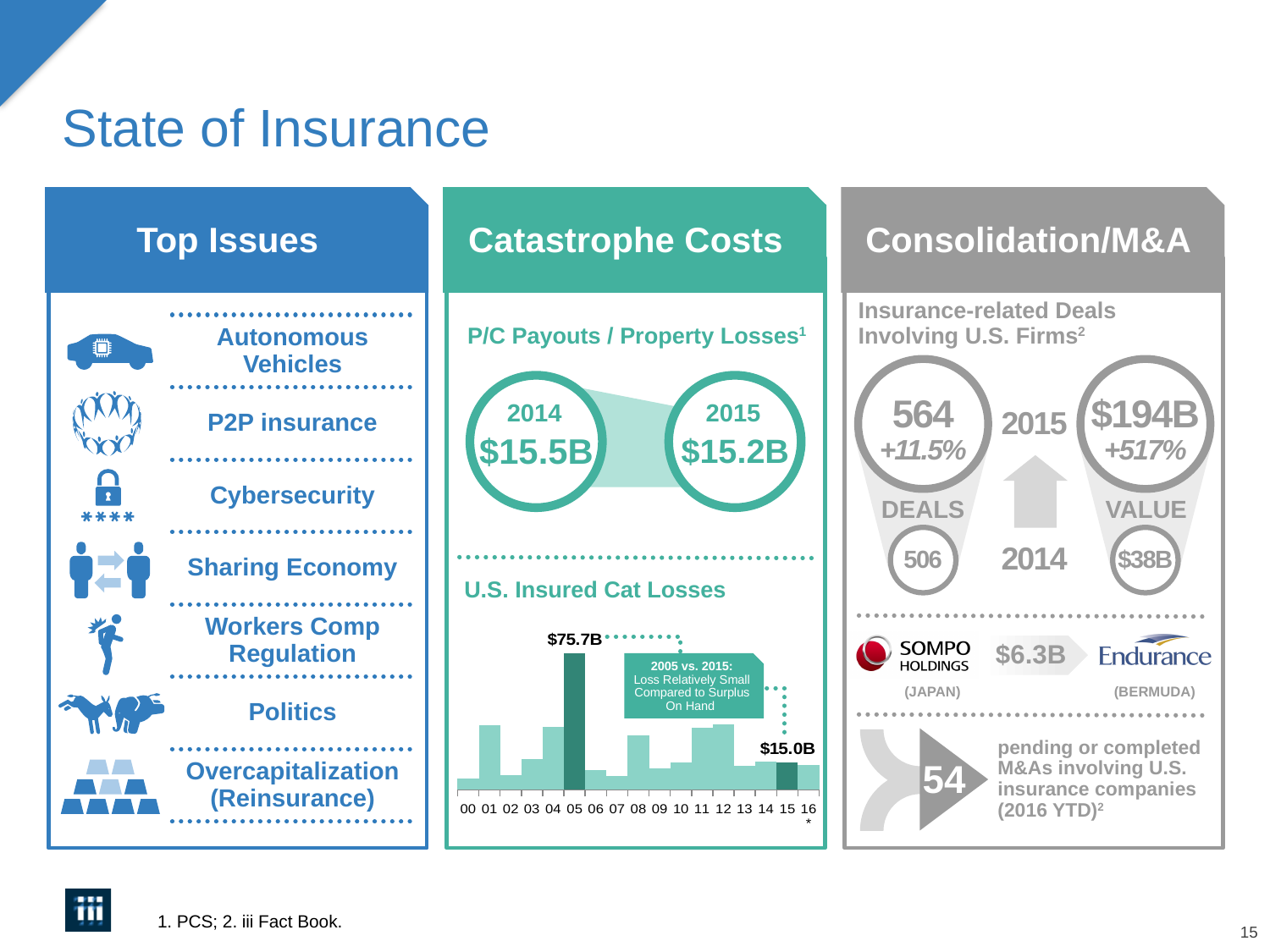
In the U.S. Insured Cat Losses chart, which year has the larger value, 2005 or 2015? 2005 In the U.S. Insured Cat Losses chart, which year has the larger value, 01 or 02? 01 How many years are shown on the x axis of the U.S. Insured Cat Losses chart? 17 In the U.S. Insured Cat Losses chart, which year has the highest insured cat losses? 05 What does the callout box on the U.S. Insured Cat Losses chart say? 2005 vs. 2015: Loss Relatively Small Compared to Surplus On Hand What type of chart is the U.S. Insured Cat Losses chart? bar chart In the U.S. Insured Cat Losses chart, what is the value labeled for 2015? $15.0B In the U.S. Insured Cat Losses chart, what is the difference between the 2005 value and the 2015 value? $60.7B In the U.S. Insured Cat Losses chart, what is the value labeled for 2005? $75.7B What is the title of the bar chart in the Catastrophe Costs panel? U.S. Insured Cat Losses